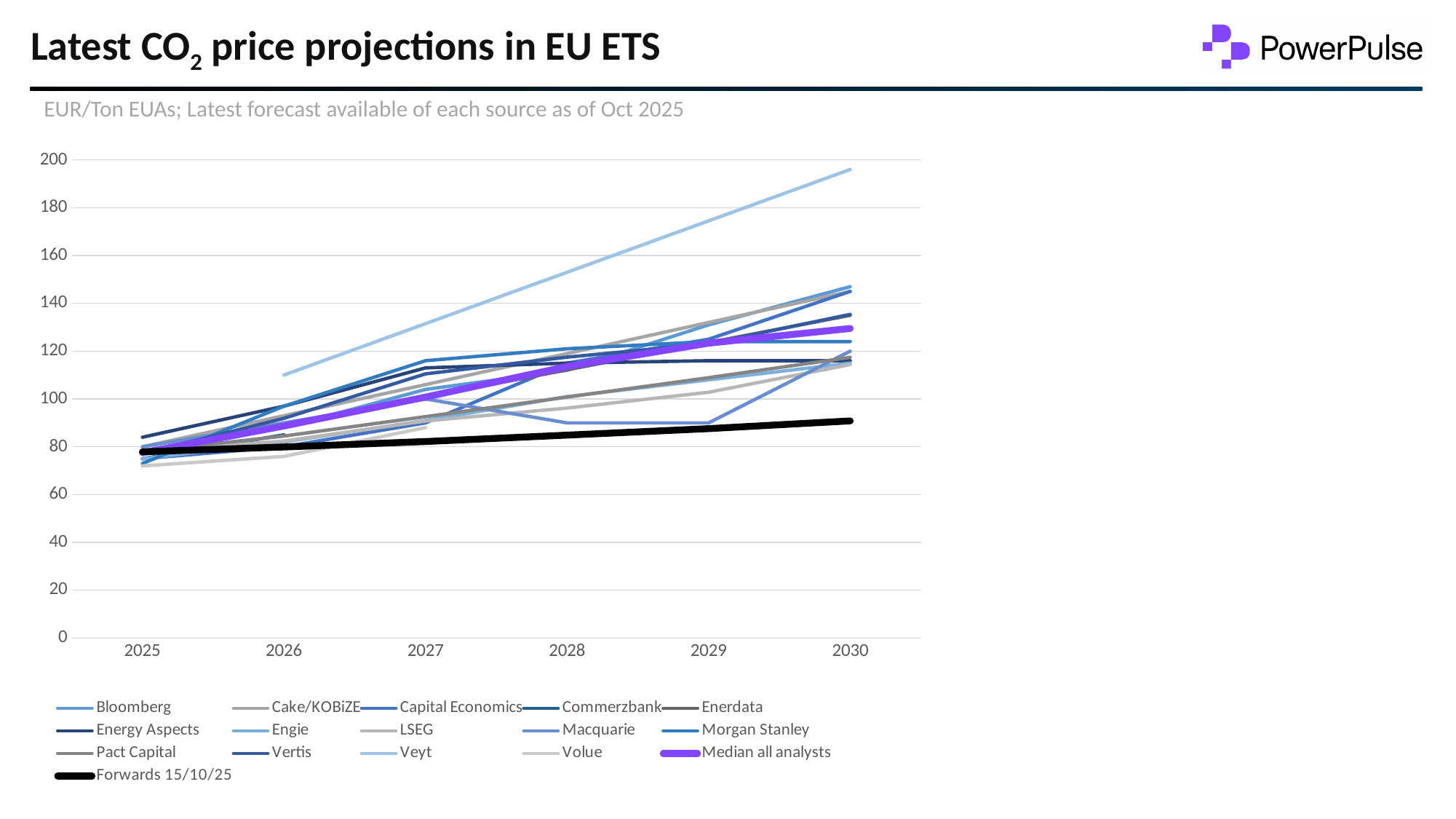
Which series has the highest value in 2030? Veyt How many series does the legend list? 16 Is the value for Forwards 15/10/25 in 2030 greater or less than 100? less What kind of chart is shown on the slide? line chart In 2030, which is larger: Median all analysts or Forwards 15/10/25? Median all analysts Does the Median all analysts line rise or fall from 2025 to 2030? rise What unit are the values expressed in, according to the subtitle? EUR/Ton EUAs Which series has the lowest value in 2030? Forwards 15/10/25 How many years are shown on the x axis? 6 Is the value for Veyt in 2030 greater or less than 180? greater What is the title of the chart? Latest CO2 price projections in EU ETS Is the value for Median all analysts in 2030 greater or less than 120? greater